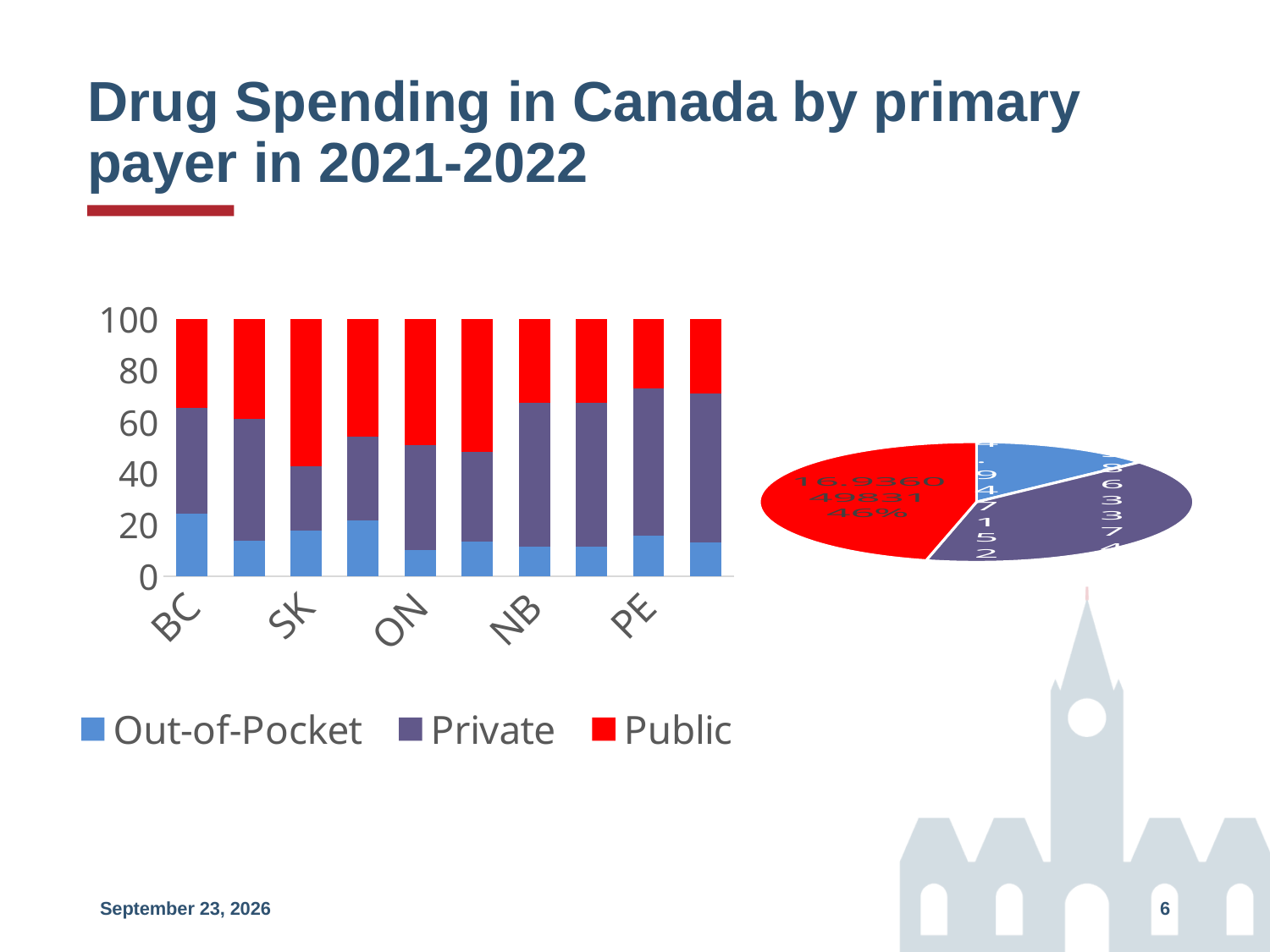
How many series does the legend of the bar chart list? 3 In the bar chart, which series forms the bottom segment of each stacked bar? Out-of-Pocket How many bars are plotted in the bar chart? 10 What kind of chart is shown on the right of the slide? pie chart What kind of chart is shown on the left of the slide? bar chart In the bar chart legend, which colour represents Public? red In the bar chart, is the Out-of-Pocket value for BC greater or less than 40? less In the bar chart, is the Public value for PE greater or less than 40? less In the bar chart, which of the labelled provinces (BC, SK, ON, NB, PE) has the largest Out-of-Pocket segment? BC What percentage is printed on the red slice of the pie chart? 46% In the bar chart, is the Out-of-Pocket value for ON greater or less than 20? less In the bar chart, which has the larger Out-of-Pocket segment, BC or ON? BC